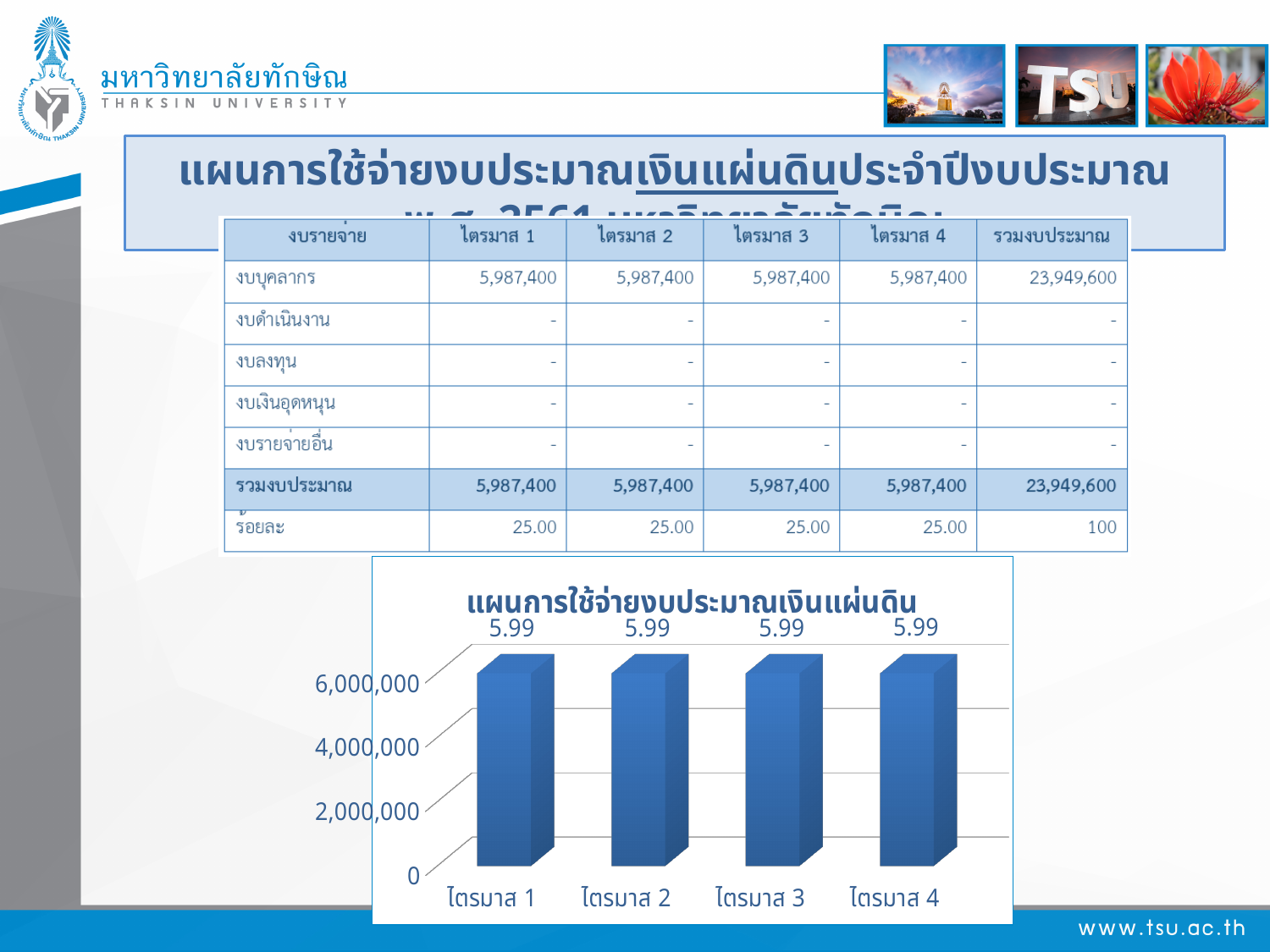
What is the title of the chart? แผนการใช้จ่ายงบประมาณเงินแผ่นดิน Is the value for ไตรมาส 2 greater or less than 4,000,000? greater How many categories are plotted on the x axis of the chart? 4 What kind of chart is shown on the slide? bar chart Is the value for ไตรมาส 4 greater or less than 2,000,000? greater What is the difference between the data labels for ไตรมาส 1 and ไตรมาส 2? 0 What is the data label shown above the bar for ไตรมาส 3? 5.99 What is the highest tick value shown on the y axis of the chart? 6,000,000 What is the data label shown above the bar for ไตรมาส 4? 5.99 Do the bar values rise, fall, or stay the same from ไตรมาส 1 to ไตรมาส 4? stay the same What is the data label shown above the bar for ไตรมาส 1? 5.99